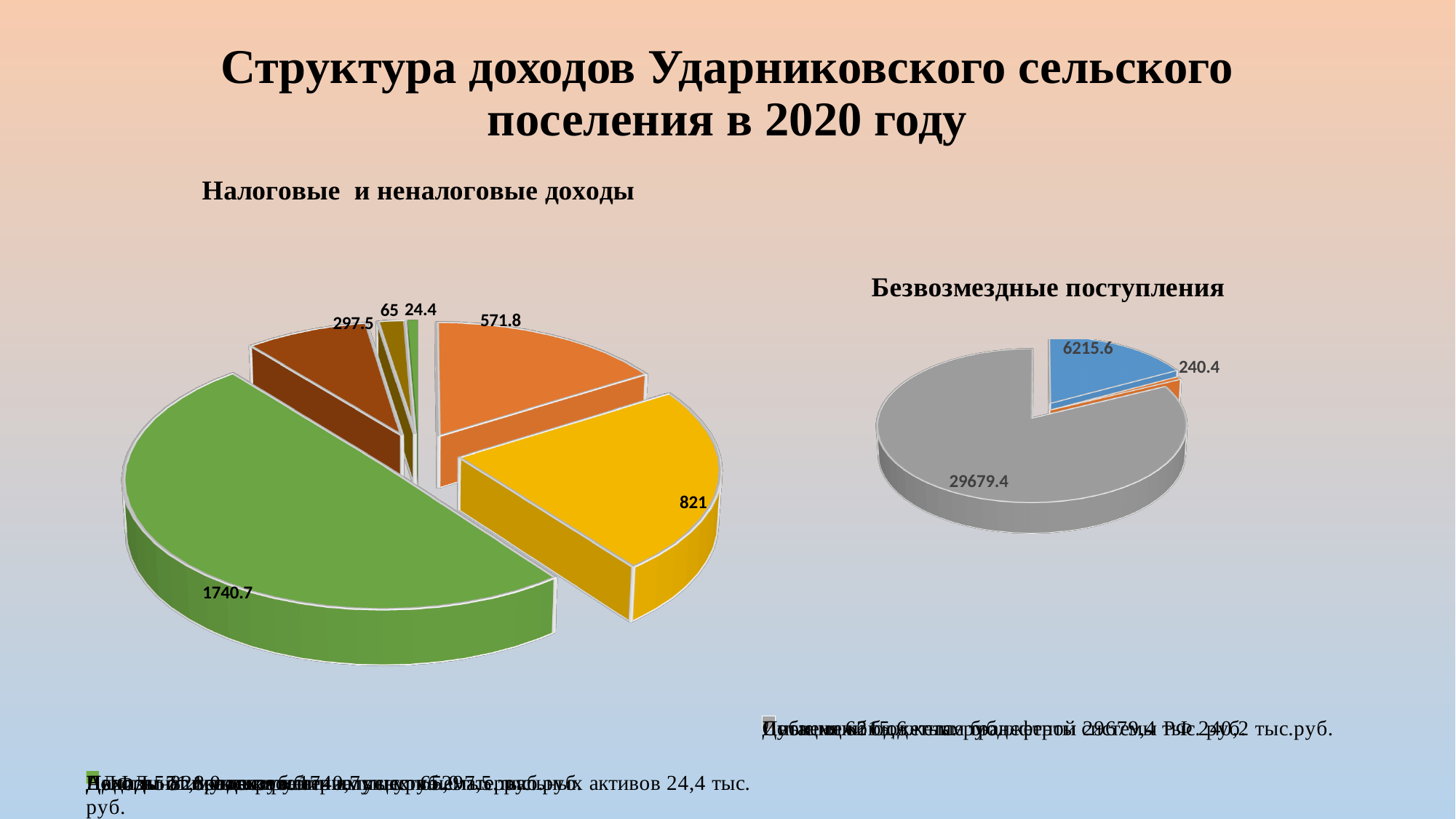
In the 'Безвозмездные поступления' chart, what is the value of the smallest slice? 240.4 In the 'Налоговые и неналоговые доходы' chart, what is the value of the largest slice? 1740.7 In the 'Налоговые и неналоговые доходы' chart, what is the difference between the yellow slice (821) and the orange slice (571.8)? 249.2 What is the title of the pie chart on the right side of the slide? Безвозмездные поступления In the 'Налоговые и неналоговые доходы' chart, which is larger: the yellow slice or the orange slice? the yellow slice In the 'Безвозмездные поступления' chart, what is the difference between the grey slice (29679.4) and the blue slice (6215.6)? 23463.8 How many slices does the 'Налоговые и неналоговые доходы' pie chart have? 6 In the 'Налоговые и неналоговые доходы' chart, what is the value of the smallest slice? 24.4 What kind of chart is the 'Налоговые и неналоговые доходы' chart on the left? pie chart What is the total of all slices in the 'Безвозмездные поступления' chart? 36135.4 In the 'Безвозмездные поступления' chart, what is the value of the largest slice? 29679.4 How many slices does the 'Безвозмездные поступления' pie chart have? 3